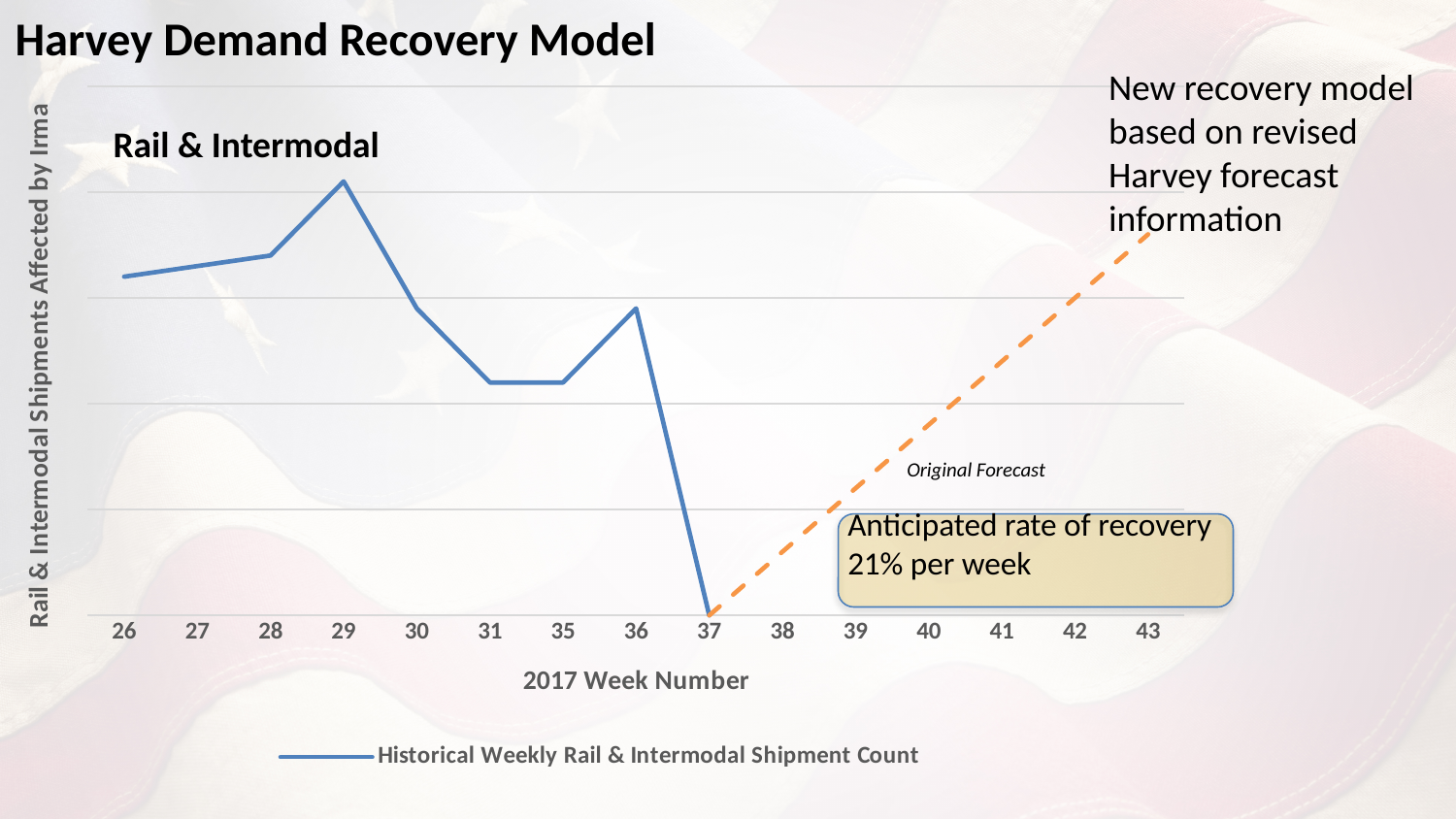
What kind of chart is shown on the slide? Line chart At which week number does the historical shipment count reach its lowest point? 37 Does the historical shipment count rise or fall from week 36 to week 37? Fall At which week number does the historical shipment count reach its highest point? 29 What is the title of the chart? Rail & Intermodal Does the historical shipment count rise or fall from week 29 to week 31? Fall Which week has a higher historical shipment count, week 28 or week 30? 28 Which week has a higher historical shipment count, week 29 or week 31? 29 Does the historical shipment count rise or fall from week 26 to week 29? Rise How many series does the chart legend list? 1 How many week numbers are shown on the x axis of the chart? 15 What is the legend entry for the blue line? Historical Weekly Rail & Intermodal Shipment Count